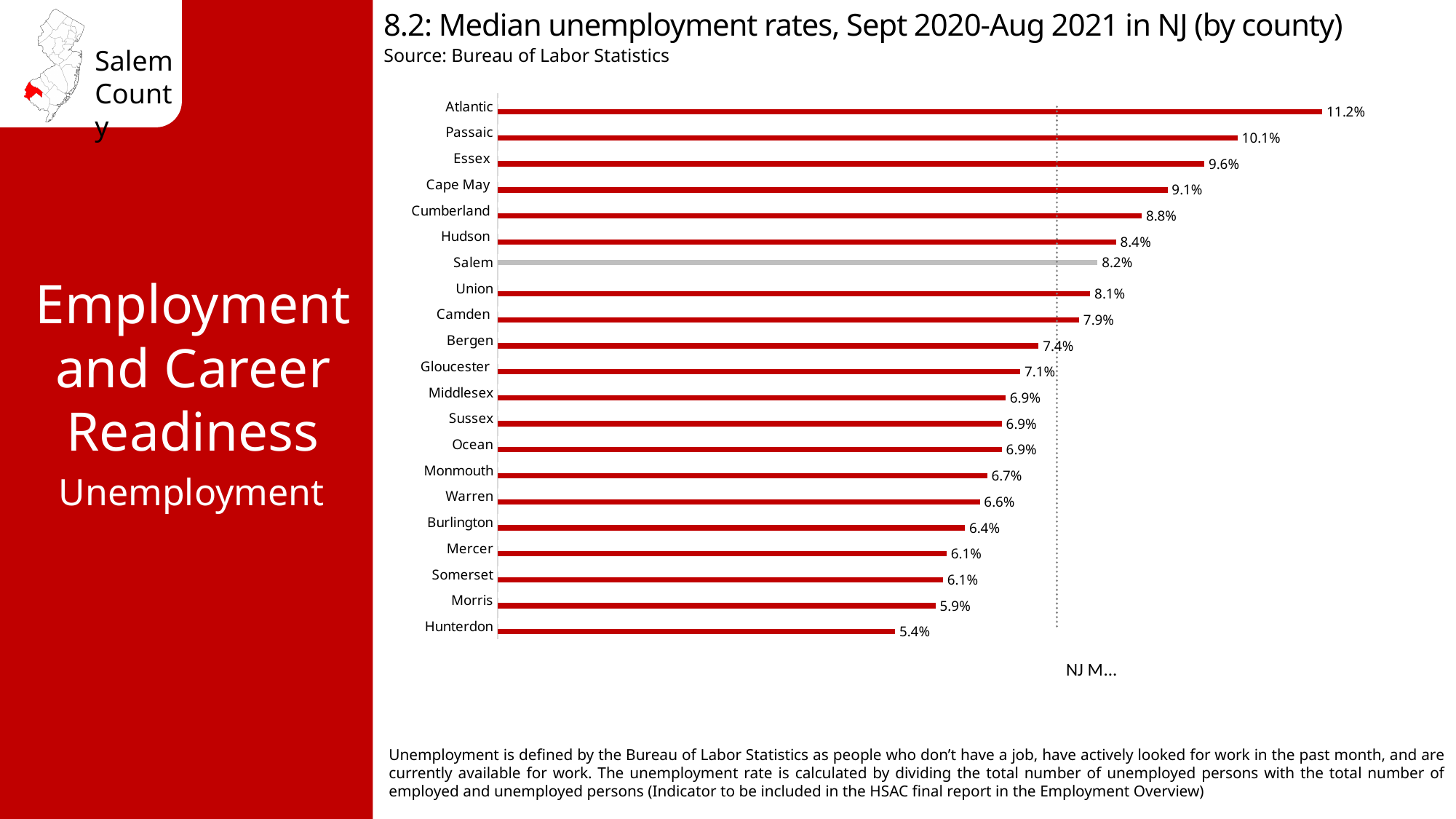
What is the difference between the median unemployment rates of Salem and Gloucester counties? 1.1% Which county has the lowest median unemployment rate? Hunterdon What is the median unemployment rate for Salem County? 8.2% How many counties are shown in the chart? 21 Which county's bar is shown in grey rather than red? Salem Which county has the highest median unemployment rate? Atlantic What is the median unemployment rate for Cumberland County? 8.8% What kind of chart is used to show the median unemployment rates? Bar chart Which county has a higher median unemployment rate, Salem or Camden? Salem What is the difference between the median unemployment rates of Atlantic and Hunterdon counties? 5.8% Which county has a higher median unemployment rate, Passaic or Essex? Passaic What is the median unemployment rate for Hunterdon County? 5.4%